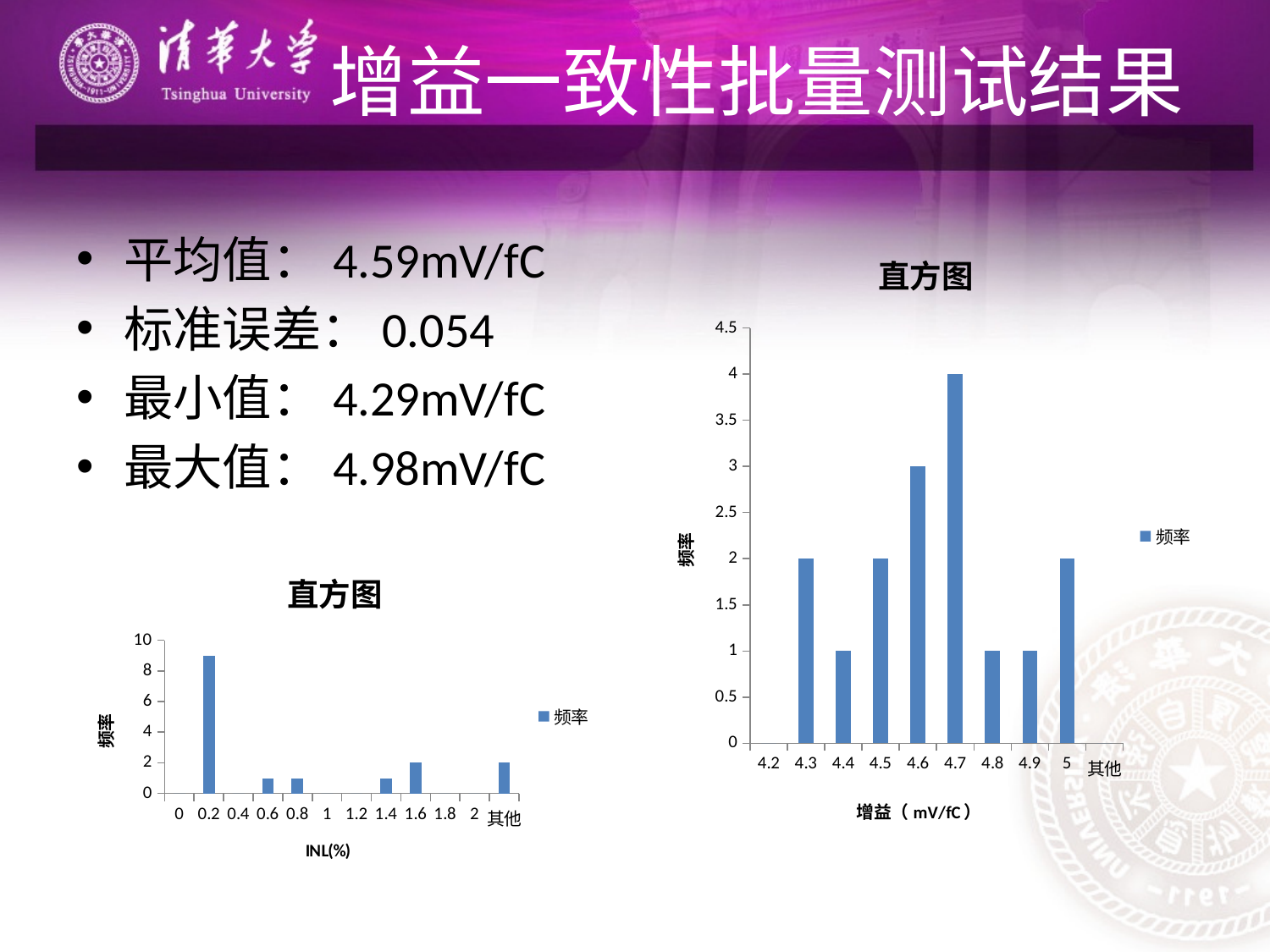
On the right-hand chart (x axis 增益 (mV/fC)), what is the 频率 value for 4.7? 4 On the right-hand chart (x axis 增益 (mV/fC)), which category has the highest 频率? 4.7 On the right-hand chart (x axis 增益 (mV/fC)), what is the 频率 value for 4.6? 3 On the right-hand chart (x axis 增益 (mV/fC)), which has the larger 频率, 4.3 or 4.4? 4.3 On the right-hand chart (x axis 增益 (mV/fC)), what is the difference between the 频率 values for 4.7 and 4.6? 1 On the right-hand chart (x axis 增益 (mV/fC)), what kind of chart is shown? bar chart On the bottom-left chart (x axis INL(%)), what is the 频率 value for 1.6? 2 On the bottom-left chart (x axis INL(%)), is the 频率 value for 0.2 greater or less than 8? greater On the bottom-left chart, what is the x-axis title? INL(%) On the right-hand chart (x axis 增益 (mV/fC)), how many series does the legend list? 1 On the right-hand chart (x axis 增益 (mV/fC)), how many categories are shown on the x axis? 10 On the bottom-left chart (x axis INL(%)), which category has the highest 频率? 0.2